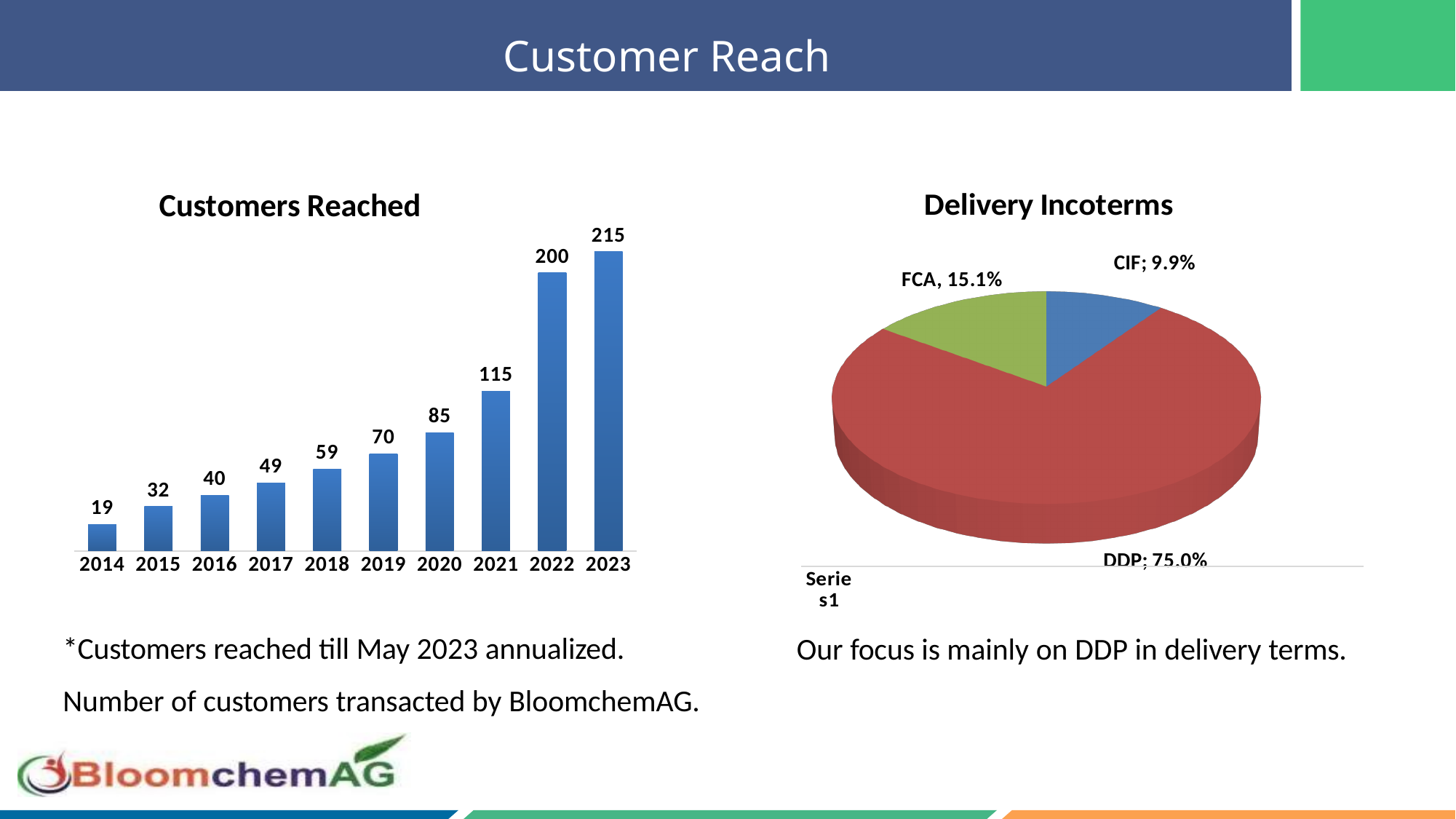
In the Delivery Incoterms chart, what share does FCA have? 15.1% In the Customers Reached chart, which year has the lowest value? 2014 What kind of chart is the Delivery Incoterms chart? pie chart What kind of chart is the Customers Reached chart? bar chart In the Customers Reached chart, which year has the highest value? 2023 In the Delivery Incoterms chart, which slice is the smallest? CIF In the Customers Reached chart, how many years are shown on the x axis? 10 In the Customers Reached chart, do the values rise or fall from 2014 to 2023? rise In the Customers Reached chart, what is the difference between the values for 2023 and 2022? 15 In the Delivery Incoterms chart, what share does DDP have? 75.0% In the Customers Reached chart, what is the value for 2018? 59 In the Customers Reached chart, what is the value for 2022? 200